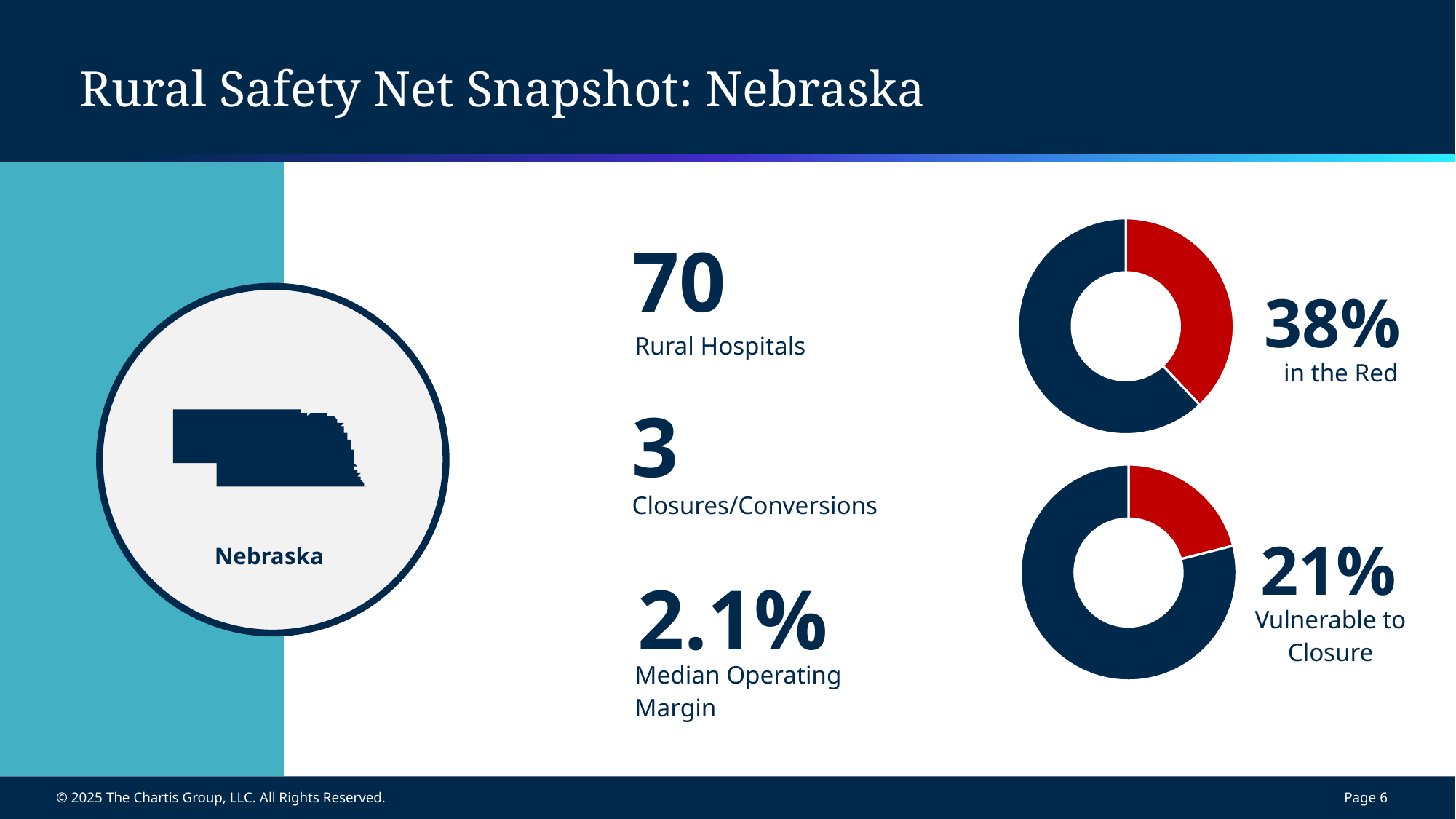
On the lower donut chart, what share of rural hospitals is shown as Vulnerable to Closure? 21% What is the difference between the 'in the Red' share and the 'Vulnerable to Closure' share? 17% What label accompanies the 21% donut chart? Vulnerable to Closure What kind of chart is used to show the 38% in the Red figure? Donut (pie) chart On the lower donut chart, is the red 'Vulnerable to Closure' slice greater or less than half of the ring? less On the upper donut chart, is the red 'in the Red' slice greater or less than half of the ring? less How many donut charts are shown on the slide? 2 What colour is used for the highlighted share in both donut charts? Red Which donut chart has the larger red slice, the 'in the Red' chart or the 'Vulnerable to Closure' chart? in the Red How many slices does the upper 'in the Red' donut chart have? 2 On the upper donut chart, what share of rural hospitals is shown as in the Red? 38%